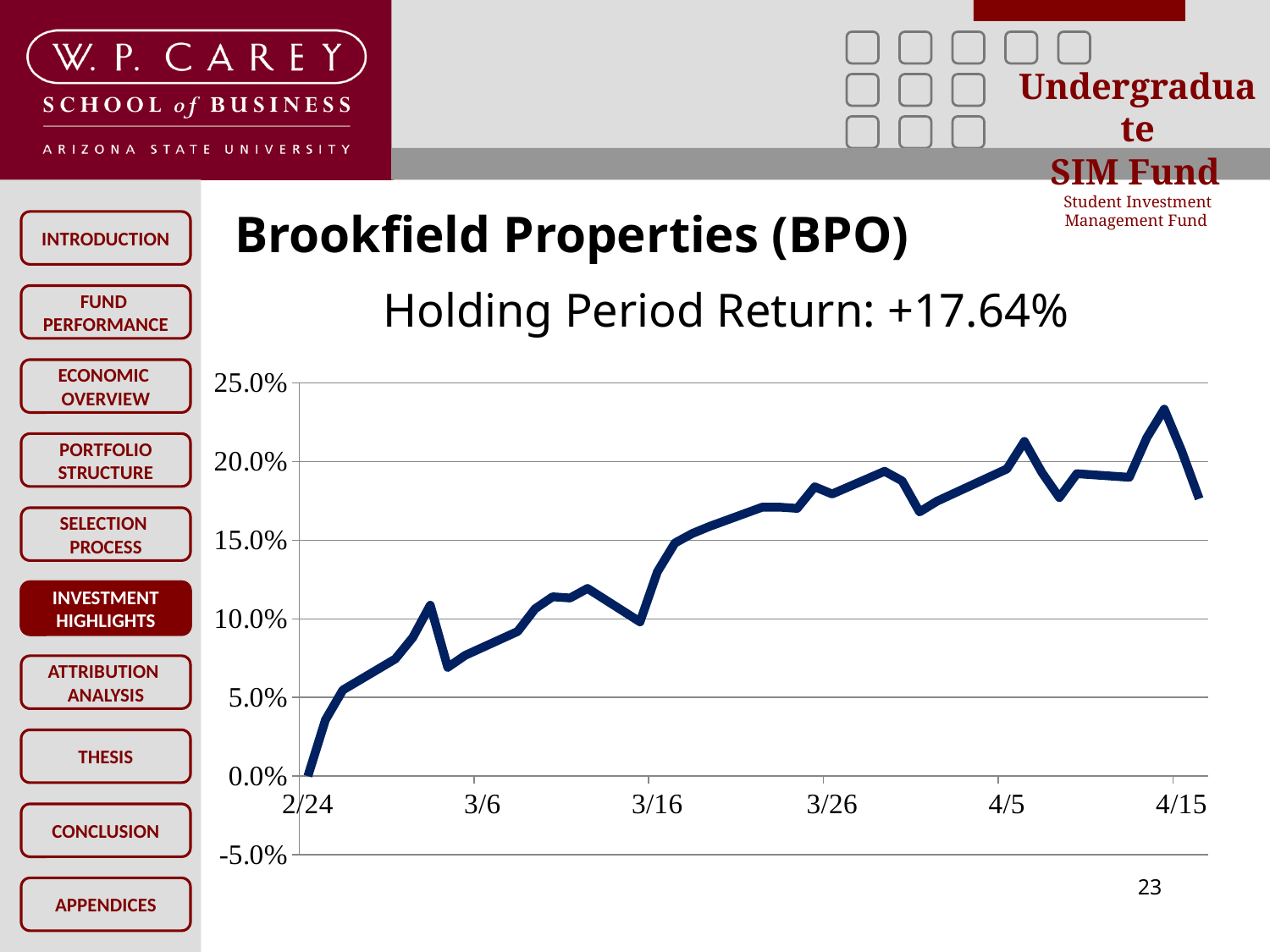
Is the value for 4/15 greater or less than 20.0%? greater Is the value for 3/26 greater or less than 15.0%? greater Which date has the larger value, 3/6 or 3/26? 3/26 At which x-axis date does the line reach its lowest value? 2/24 What holding period return is stated in the chart subtitle? +17.64% Is the value for 3/6 greater or less than 5.0%? greater What is the title of the chart on the slide? Brookfield Properties (BPO) What is the value of the line at 2/24? 0.0% What kind of chart is shown on the slide? line chart Overall, does the holding period return rise or fall from 2/24 to 4/15? rise